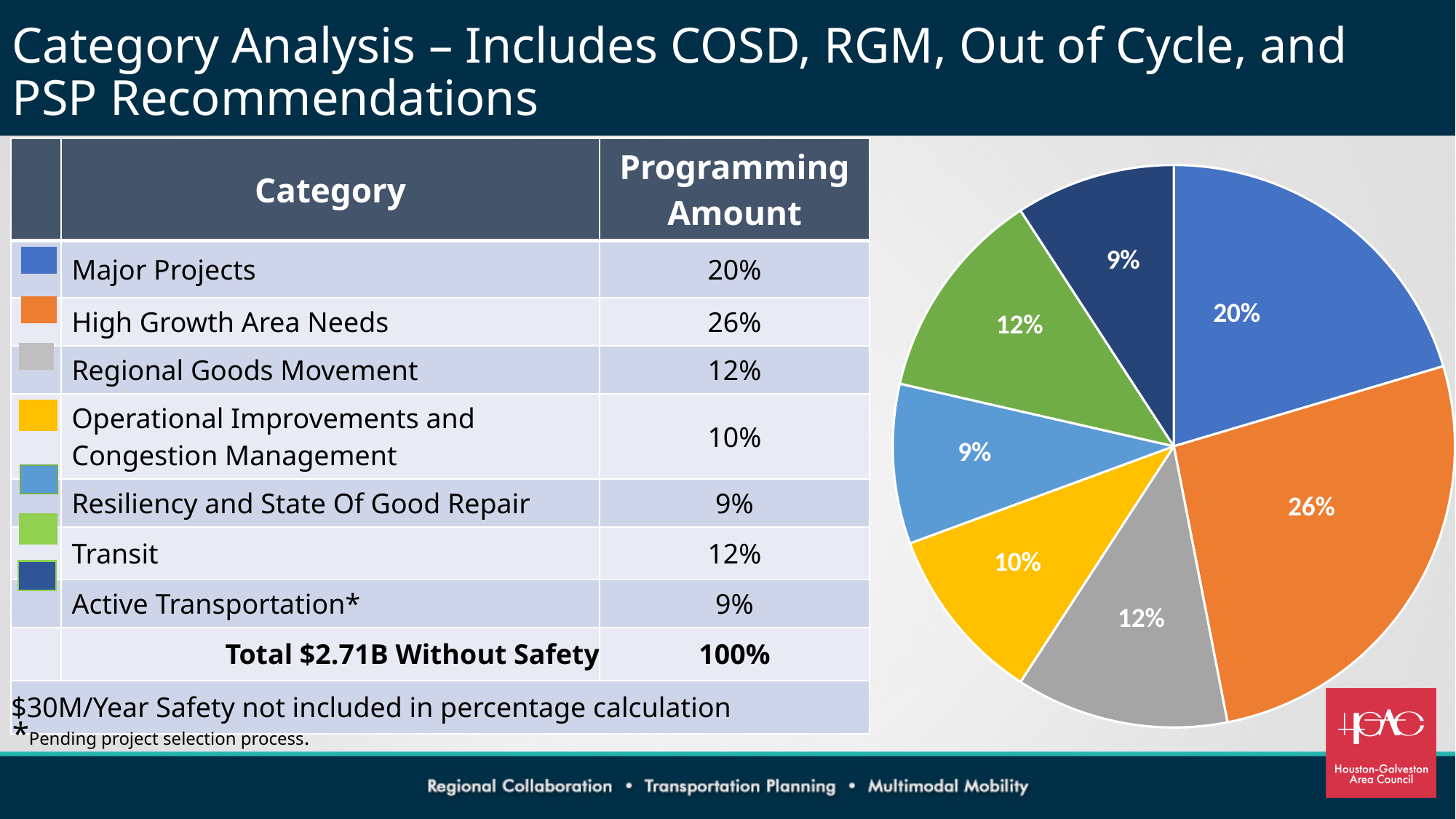
How many slices does the pie chart have? 7 What is the difference in percentage points between High Growth Area Needs and Major Projects? 6 percentage points What is the programming amount share for Transit? 12% What is the programming amount share for Major Projects? 20% What is the programming amount share for Operational Improvements and Congestion Management? 10% What colour is the largest slice of the pie chart? orange What is the programming amount share for Active Transportation? 9% Which category has the largest slice of the pie chart? High Growth Area Needs What kind of chart is shown on the slide? pie chart Which is larger, the share for Major Projects or the share for Regional Goods Movement? Major Projects What total programming amount does the table say the percentages are based on? $2.71B Without Safety What is the programming amount share for High Growth Area Needs? 26%